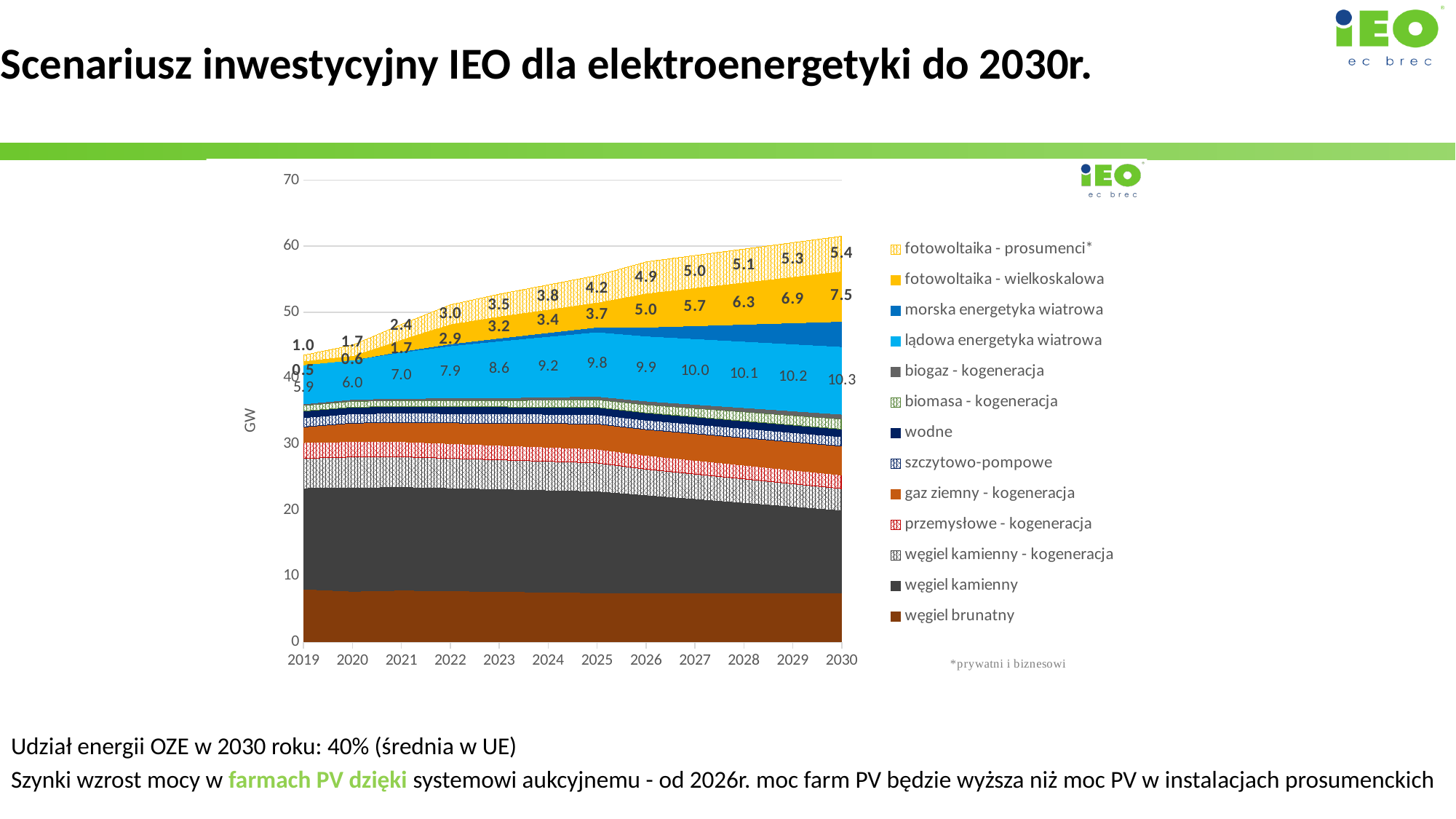
In which year is the value for 'fotowoltaika - prosumenci' lowest? 2019 What is the value for 'fotowoltaika - wielkoskalowa' in 2026? 5.0 What unit is shown on the y axis label? GW What type of chart is shown on the slide? stacked area chart How many years are shown on the x axis? 12 Does the value for 'lądowa energetyka wiatrowa' rise or fall from 2019 to 2030? rise In which year is the value for 'fotowoltaika - wielkoskalowa' highest? 2030 What is the value for 'fotowoltaika - prosumenci' in 2030? 5.4 What is the difference between the 'fotowoltaika - wielkoskalowa' value in 2030 and in 2019? 7.0 How many series does the legend list? 13 What is the value for 'lądowa energetyka wiatrowa' in 2019? 5.9 In 2028, which is larger: 'fotowoltaika - wielkoskalowa' or 'fotowoltaika - prosumenci'? fotowoltaika - wielkoskalowa